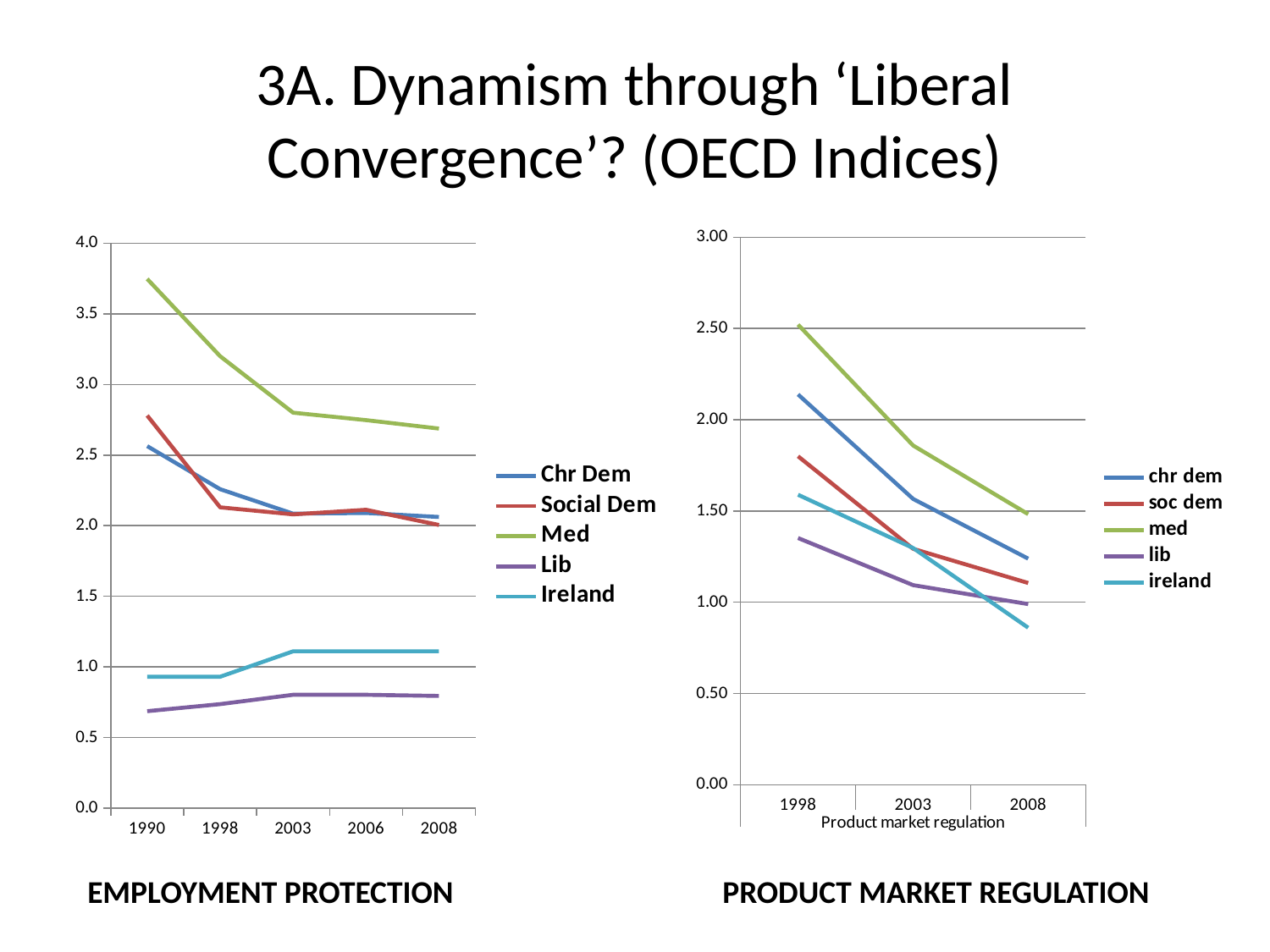
What kind of chart is the Employment Protection chart on the left? line chart In the Employment Protection chart, is the value for Med in 1990 greater or less than 3.5? greater In the Employment Protection chart, which series has the lowest value in 2008? Lib In the Product Market Regulation chart, which is larger in 1998: the value for lib or the value for ireland? ireland How many years are shown on the x axis of the Product Market Regulation chart? 3 How many years are shown on the x axis of the Employment Protection chart? 5 In the Product Market Regulation chart, is the value for chr dem in 1998 greater or less than 2.00? greater In the Product Market Regulation chart, which series has the lowest value in 2008? ireland In the Employment Protection chart, is the value for Lib in 1990 greater or less than 1.0? less In the Employment Protection chart, which series has the highest value in 1990? Med In the Employment Protection chart, does the Med line rise or fall from 1990 to 2008? fall How many series does the legend of the Employment Protection chart list? 5